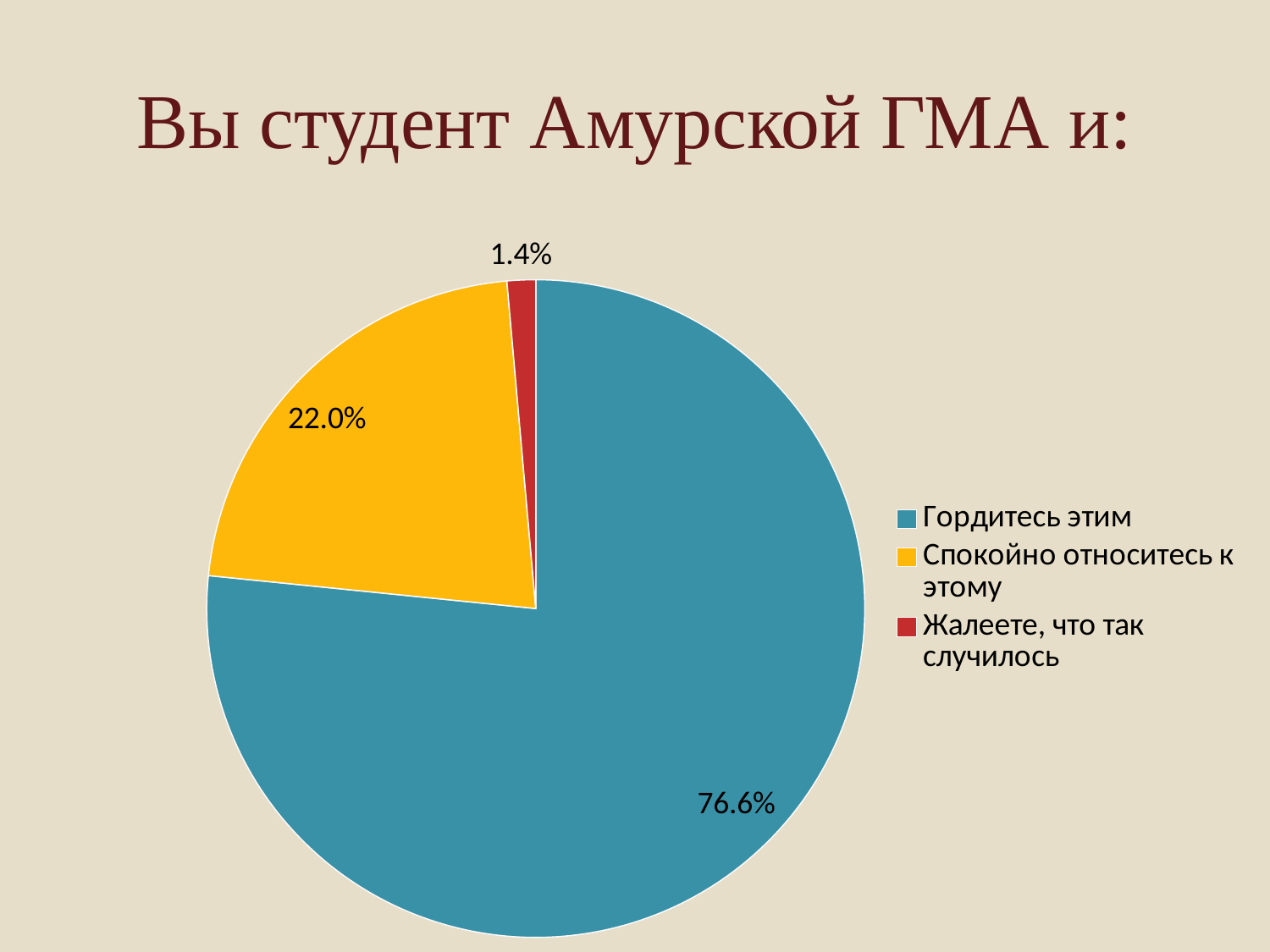
Which is larger: the slice for "Спокойно относитесь к этому" or the slice for "Жалеете, что так случилось"? Спокойно относитесь к этому Which category has the smallest slice of the pie? Жалеете, что так случилось What is the difference in percentage points between "Гордитесь этим" and "Спокойно относитесь к этому"? 54.6 What kind of chart is shown on the slide? pie chart What is the difference in percentage points between "Спокойно относитесь к этому" and "Жалеете, что так случилось"? 20.6 Which category has the largest slice of the pie? Гордитесь этим What colour is the slice for "Гордитесь этим"? blue How many slices does the pie chart have? 3 What share of the pie is labelled "Спокойно относитесь к этому"? 22.0% What share of the pie is labelled "Гордитесь этим"? 76.6% What is the title of the slide above the chart? Вы студент Амурской ГМА и: What share of the pie is labelled "Жалеете, что так случилось"? 1.4%